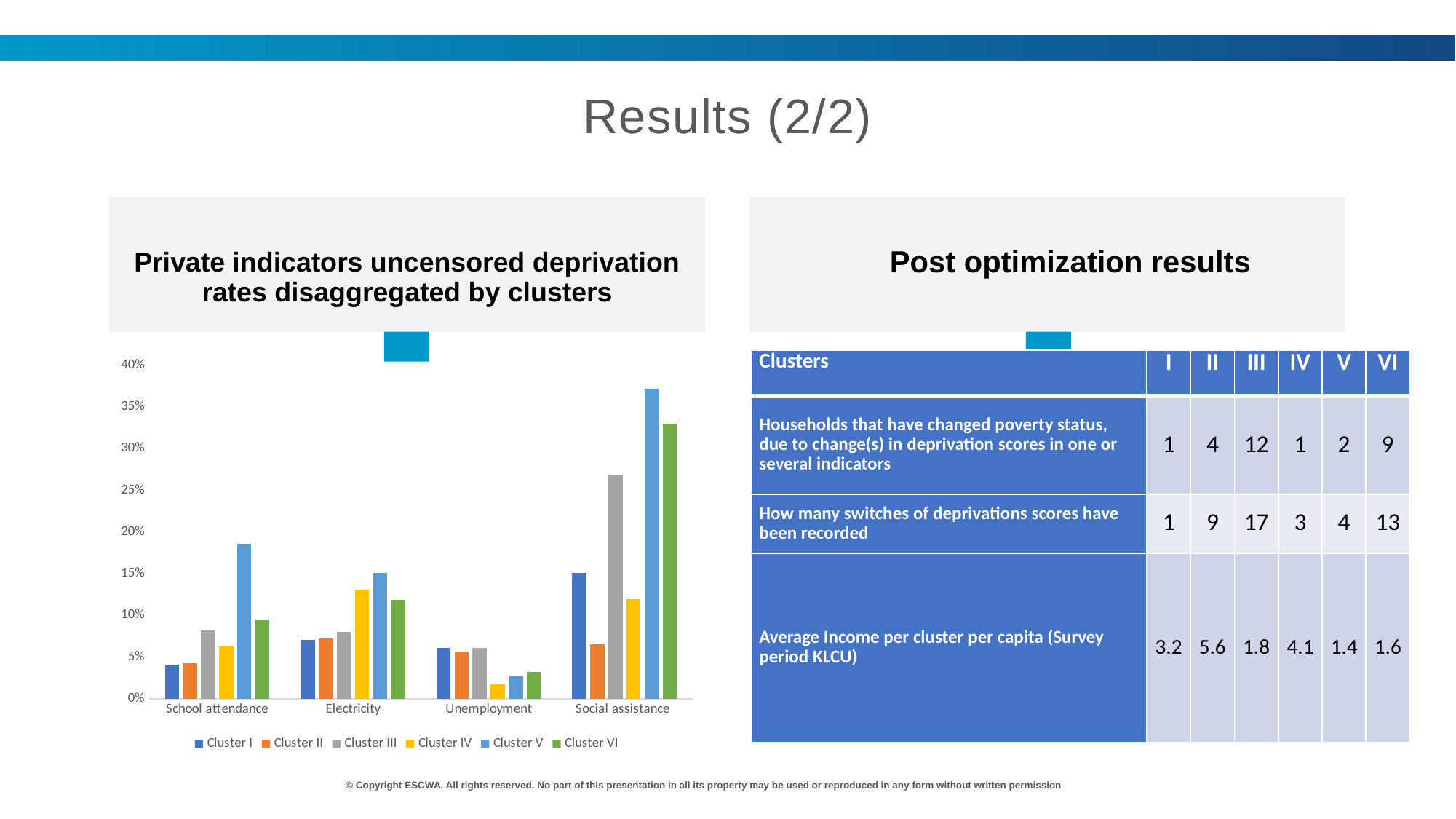
Which cluster has the lowest bar in the Unemployment category? Cluster IV What is the title of the chart? Private indicators uncensored deprivation rates disaggregated by clusters Is the value for Cluster VI in Social assistance greater or less than 30%? greater Which cluster has the highest bar in the School attendance category? Cluster V How many series does the chart's legend list? 6 In the Electricity category, which is larger: Cluster IV or Cluster II? Cluster IV What kind of chart is shown on the slide? bar chart Is the value for Cluster IV in Unemployment greater or less than 5%? less Is the value for Cluster V in School attendance greater or less than 15%? greater Which cluster has the highest bar in the Social assistance category? Cluster V How many categories are shown on the x axis of the chart? 4